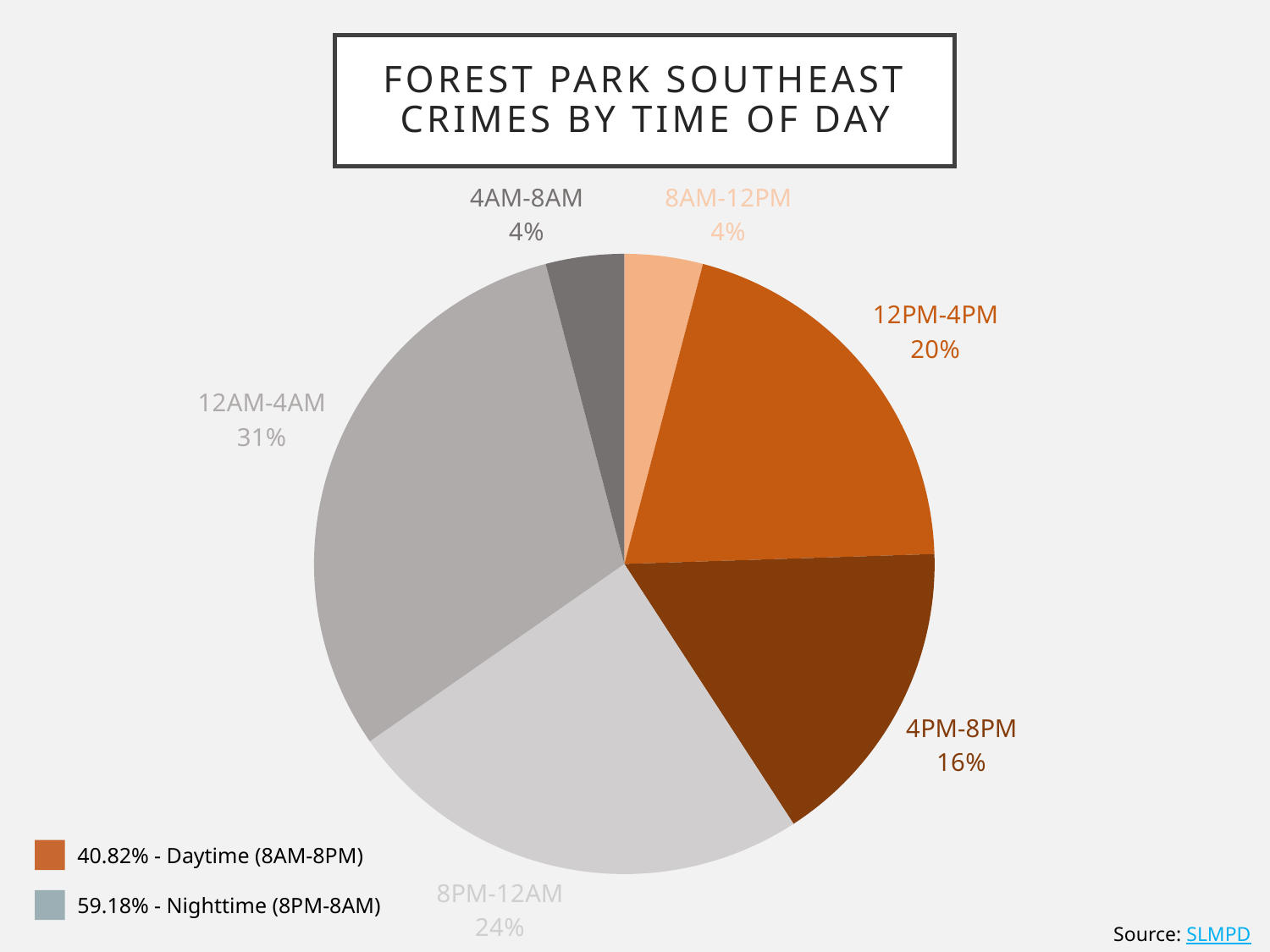
Which time-of-day slice has the largest share of crimes? 12AM-4AM What is the difference in percentage points between the 12AM-4AM slice and the 8PM-12AM slice? 7 According to the legend, what percentage of crimes occurred during nighttime (8PM-8AM)? 59.18% What percentage of crimes occurred between 4PM and 8PM? 16% What percentage of crimes occurred between 12AM and 4AM? 31% What percentage of crimes occurred between 8PM and 12AM? 24% What percentage of crimes occurred between 12PM and 4PM? 20% Which slice is larger, 12PM-4PM or 4PM-8PM? 12PM-4PM How many time-of-day slices does the pie chart have? 6 What is the combined share of the 12PM-4PM and 4PM-8PM slices? 36% What is the title of the chart? Forest Park Southeast Crimes by Time of Day What kind of chart is shown on the slide? Pie chart